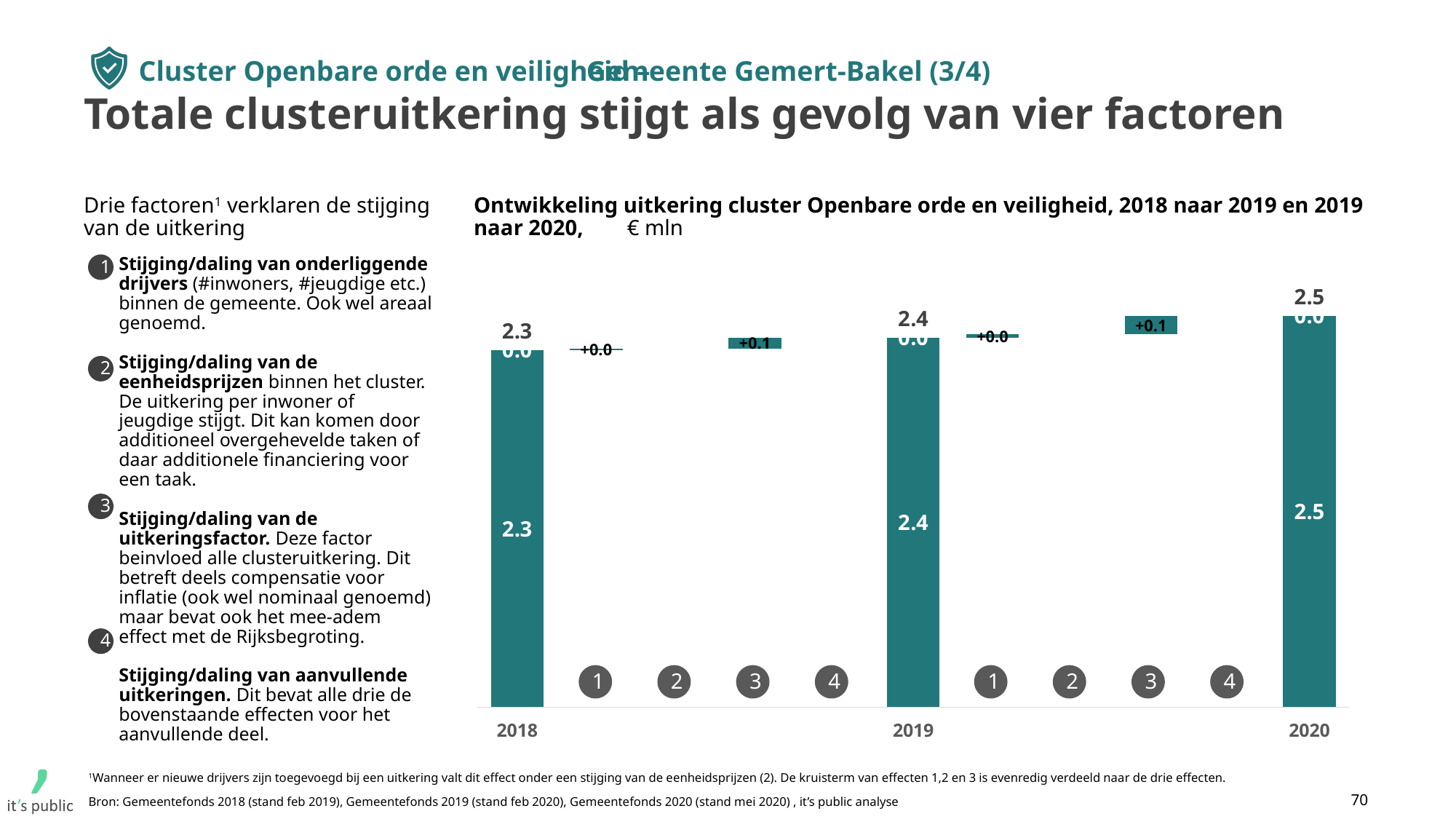
In what unit are the values in the chart expressed? € mln What is the total cluster payment shown for 2020? 2.5 Do the total cluster payments rise or fall from 2018 to 2020? rise Which year has the highest total cluster payment? 2020 What is the difference between the 2020 and 2018 totals? 0.2 What is the effect of factor 1 between 2019 and 2020? +0.0 Which is larger, the total for 2019 or the total for 2020? 2020 What is the difference between the 2019 and 2018 totals? 0.1 What is the total cluster payment shown for 2019? 2.4 What is the total cluster payment shown for 2018? 2.3 Which year has the lowest total cluster payment? 2018 What is the effect of factor 3 between 2018 and 2019? +0.1